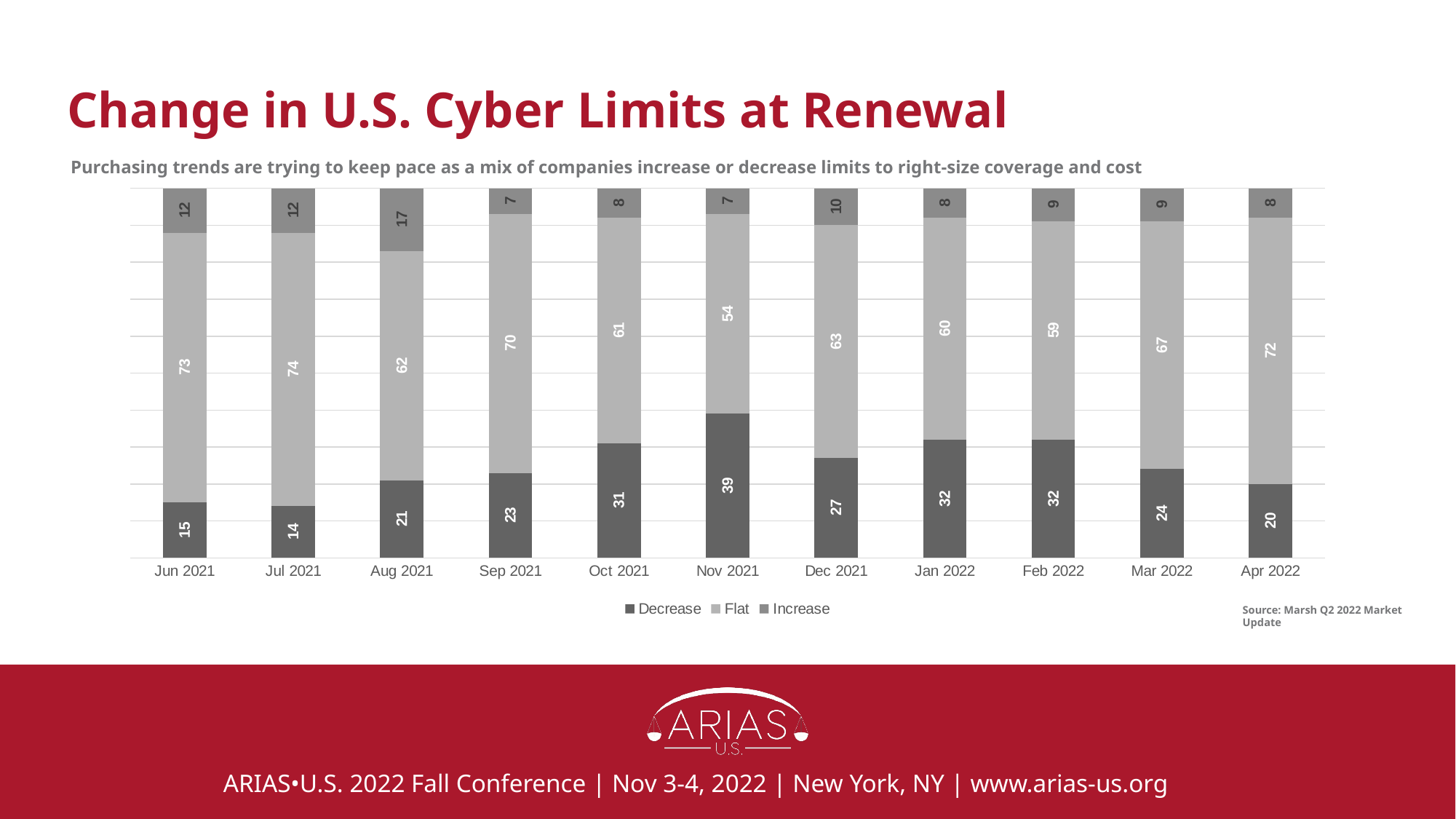
Which month has the highest Decrease value? Nov 2021 What is the Flat value for Apr 2022? 72 What kind of chart is shown on the slide? Stacked bar chart What is the difference between the Flat values for Jul 2021 and Nov 2021? 20 How many months are shown on the x axis? 11 What is the total of the stacked bar for Sep 2021? 100 What is the Decrease value for Nov 2021? 39 Which month has the highest Increase value? Aug 2021 How many series does the legend list? 3 Which is larger, the Decrease value for Oct 2021 or for Dec 2021? Oct 2021 What is the Increase value for Aug 2021? 17 Which month has the lowest Flat value? Nov 2021